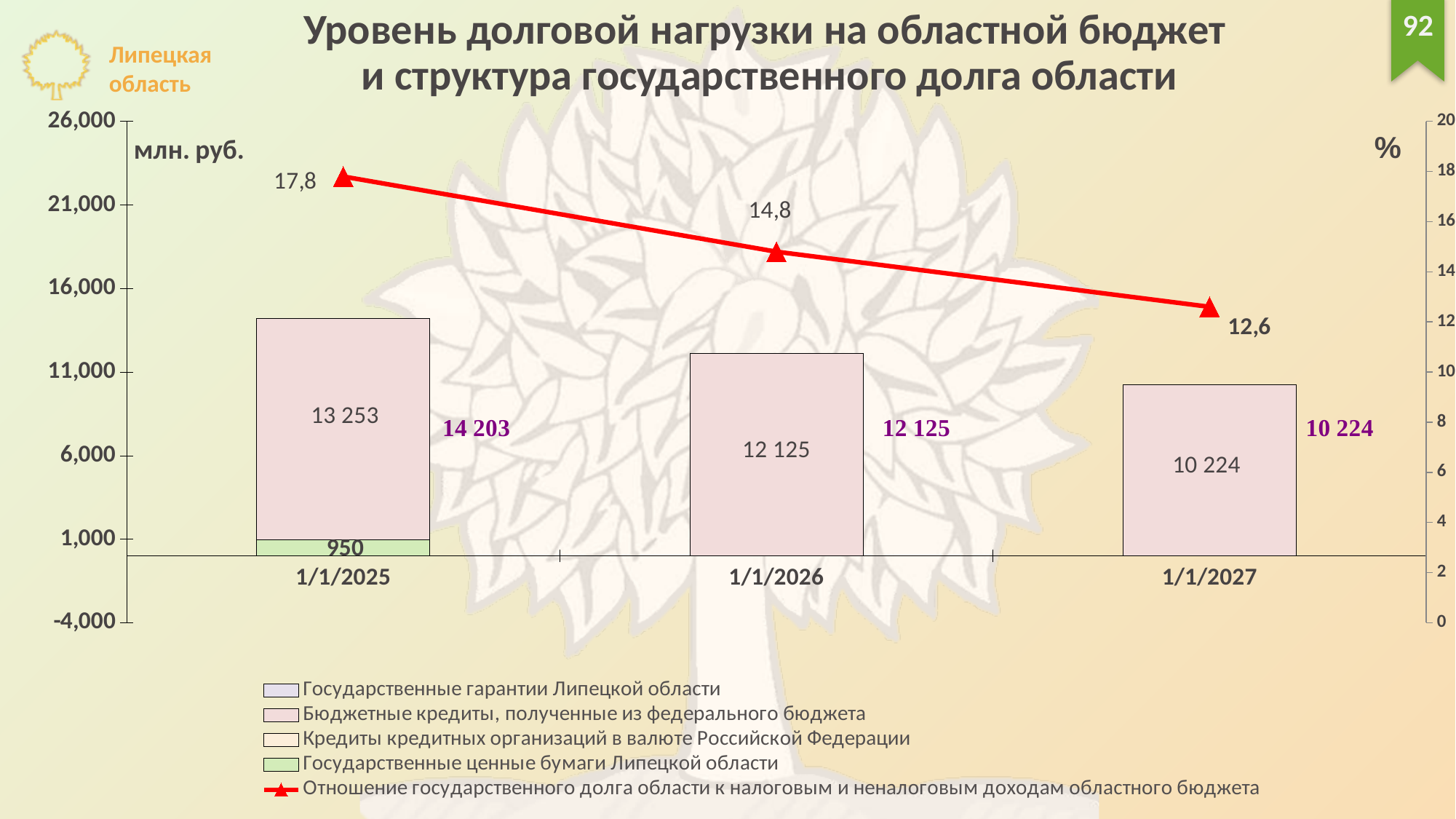
How many dates are shown on the x axis? 3 What is the value of the debt ratio line at 1/1/2027? 12,6 Which is larger: the debt ratio at 1/1/2026 or at 1/1/2027? 1/1/2026 What is the value of Бюджетные кредиты, полученные из федерального бюджета at 1/1/2026? 12 125 What is the value of Государственные ценные бумаги Липецкой области at 1/1/2025? 950 How many entries does the legend list? 5 Does the debt ratio line rise or fall from 1/1/2025 to 1/1/2027? fall At which date is the debt ratio line highest? 1/1/2025 What is the total of the stacked bar at 1/1/2025? 14 203 What is the difference between the Бюджетные кредиты values at 1/1/2025 and 1/1/2027? 3 029 What is the value of the debt ratio line (Отношение государственного долга области к налоговым и неналоговым доходам областного бюджета) at 1/1/2025? 17,8 At which date is the value of Бюджетные кредиты, полученные из федерального бюджета lowest? 1/1/2027